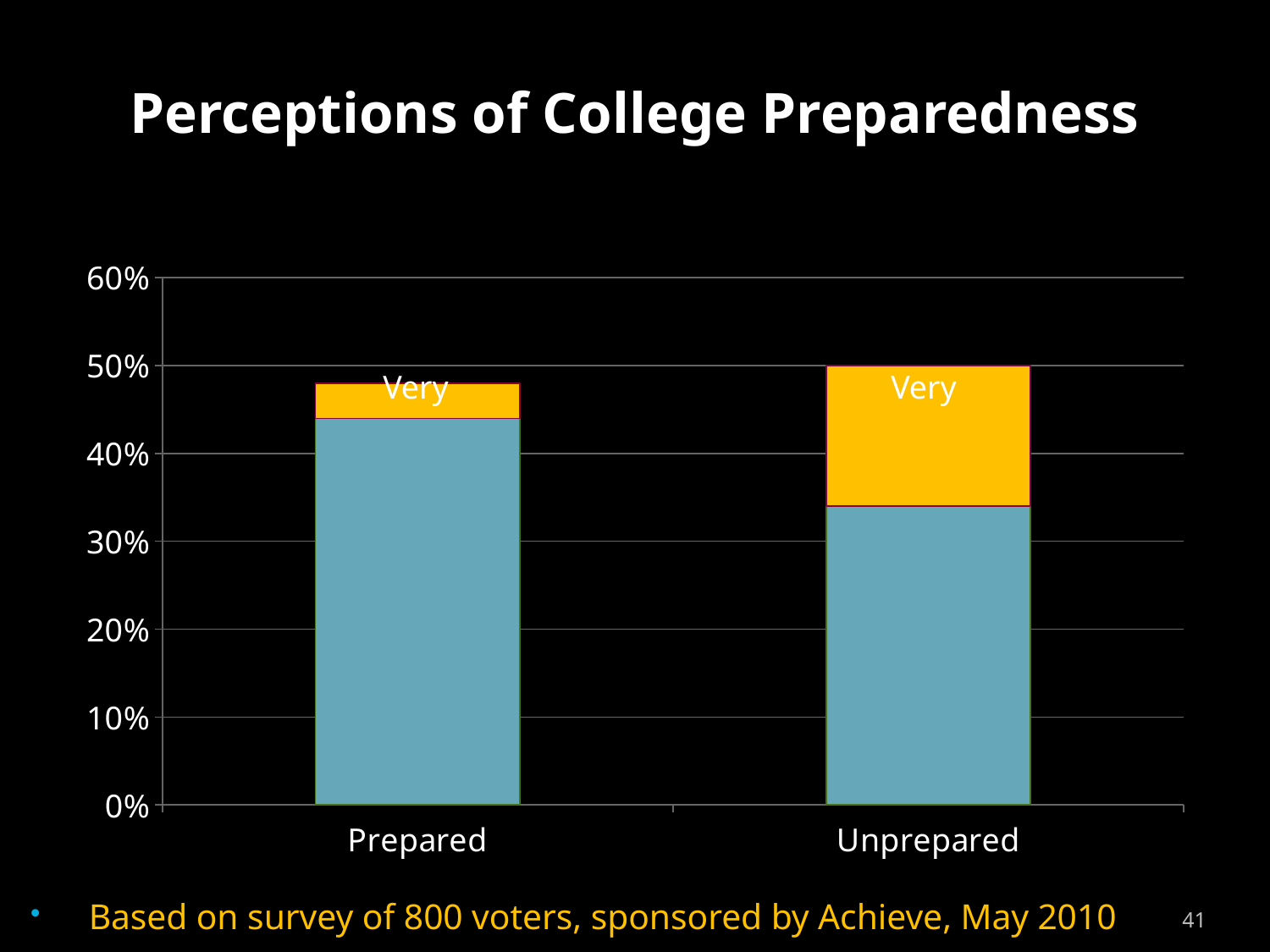
Which bar has the larger blue (bottom) segment, Prepared or Unprepared? Prepared What is the highest value shown on the y axis? 60% Is the blue (bottom) segment of the Prepared bar greater or less than 40%? greater Is the total height of the Prepared bar greater or less than 50%? less What kind of chart is shown on the slide? Stacked bar chart Is the blue (bottom) segment of the Unprepared bar greater or less than 30%? greater Which bar has the larger yellow "Very" segment, Prepared or Unprepared? Unprepared What are the two categories on the x axis? Prepared and Unprepared What is the title of the chart? Perceptions of College Preparedness How many categories are shown on the x axis? 2